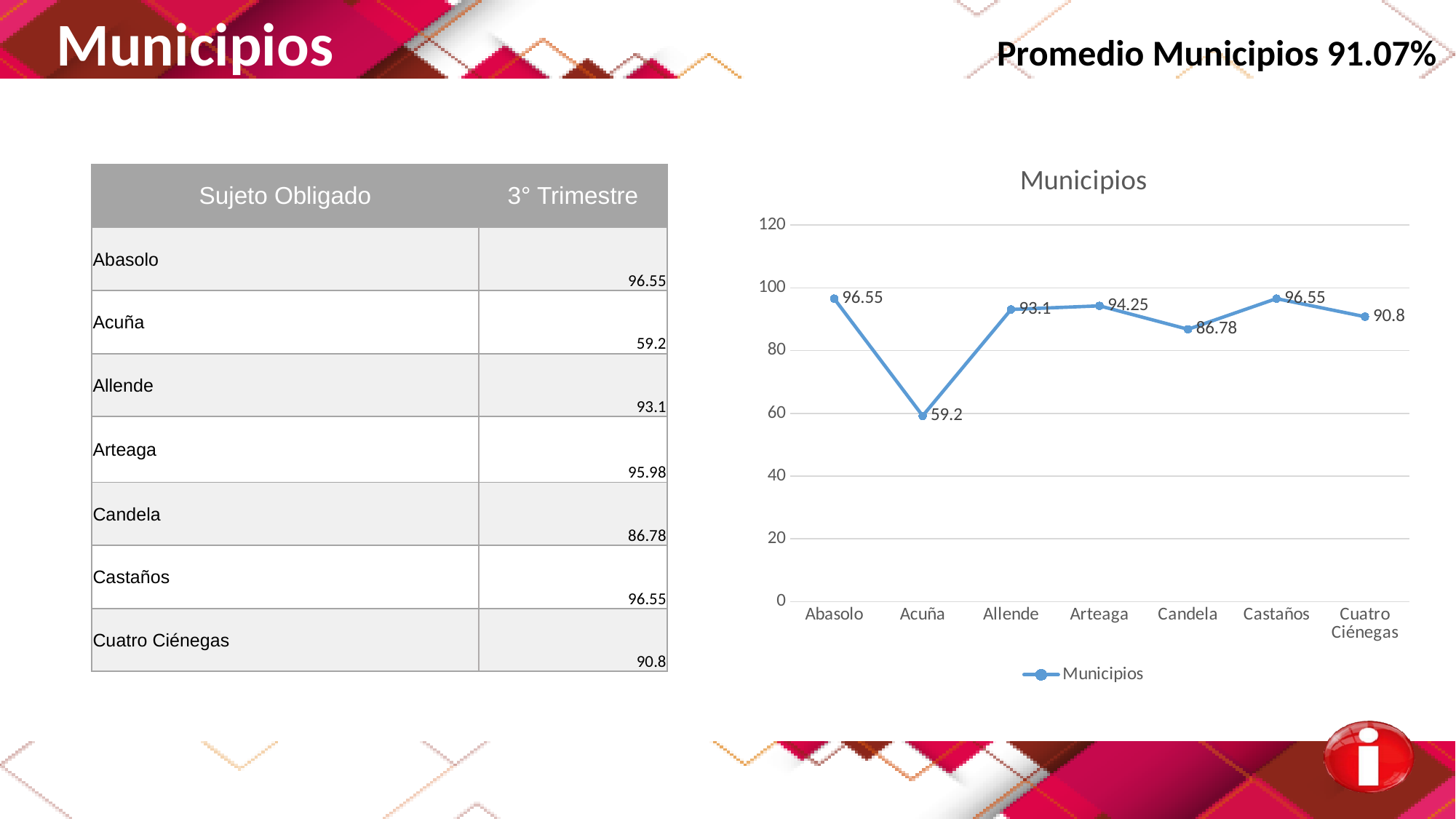
What is the value for Cuatro Ciénegas on the chart? 90.8 Which municipality has the lowest value on the chart? Acuña What type of chart is shown on the slide? Line chart What is the difference between the values for Abasolo and Acuña on the chart? 37.35 What is the value for Acuña on the chart? 59.2 Which is larger on the chart, the value for Allende or the value for Candela? Allende How many series does the chart legend list? 1 What is the value for Candela on the chart? 86.78 How many municipalities are plotted on the chart? 7 What is the title of the chart? Municipios What is the value for Allende on the chart? 93.1 Is the value for Candela on the chart greater or less than 80? greater